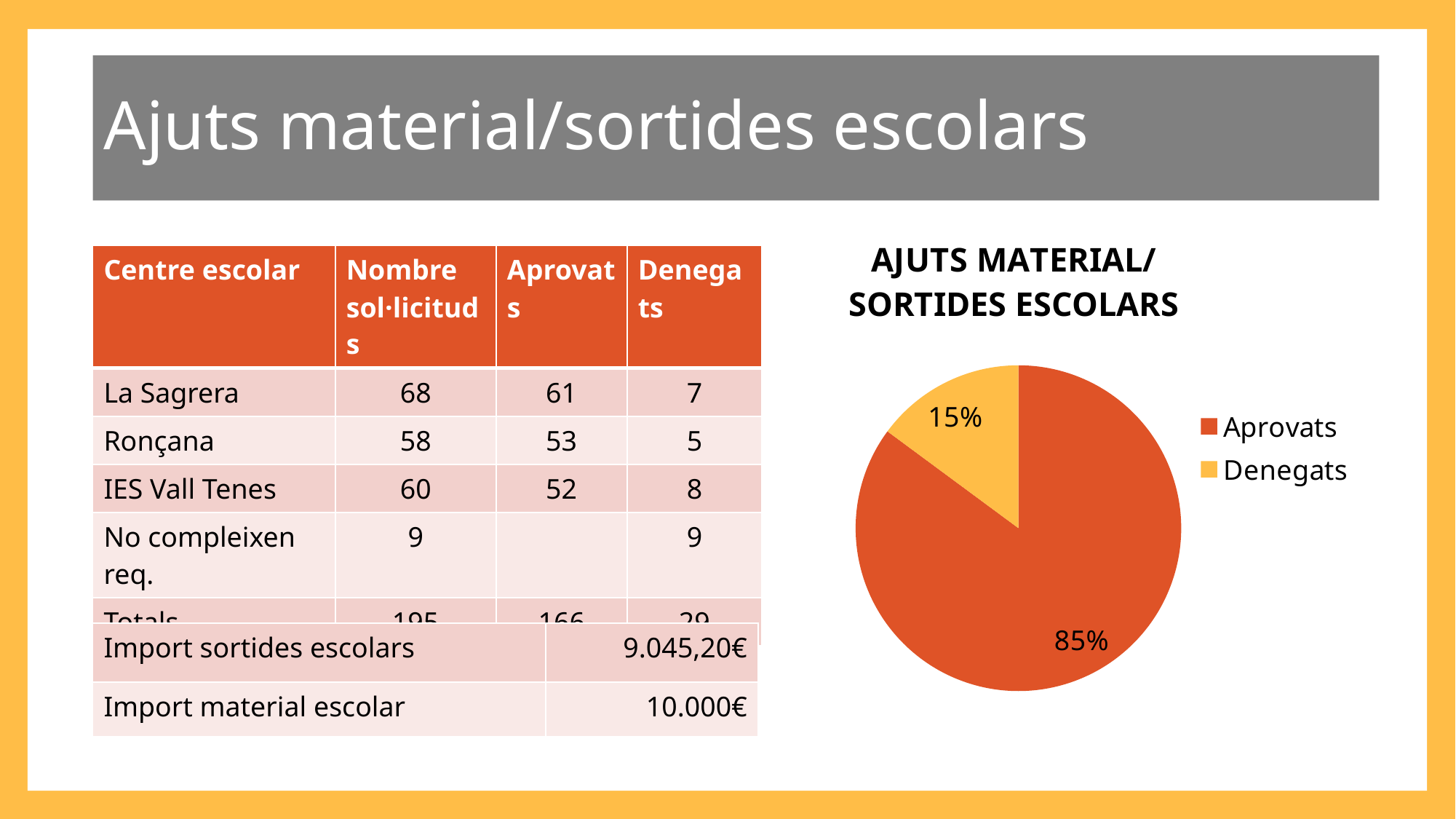
How many entries does the pie chart's legend list? 2 Which colour is used for the Denegats slice in the pie chart? yellow What is the title of the pie chart? AJUTS MATERIAL/ SORTIDES ESCOLARS What share of the pie chart does Aprovats represent? 85% What share of the pie chart does Denegats represent? 15% What kind of chart is shown on the slide? pie chart How many slices does the pie chart have? 2 What is the difference in percentage points between the Aprovats and Denegats slices? 70 Which slice of the pie chart is the smallest? Denegats Which slice of the pie chart is the largest? Aprovats Which is larger in the pie chart, Aprovats or Denegats? Aprovats